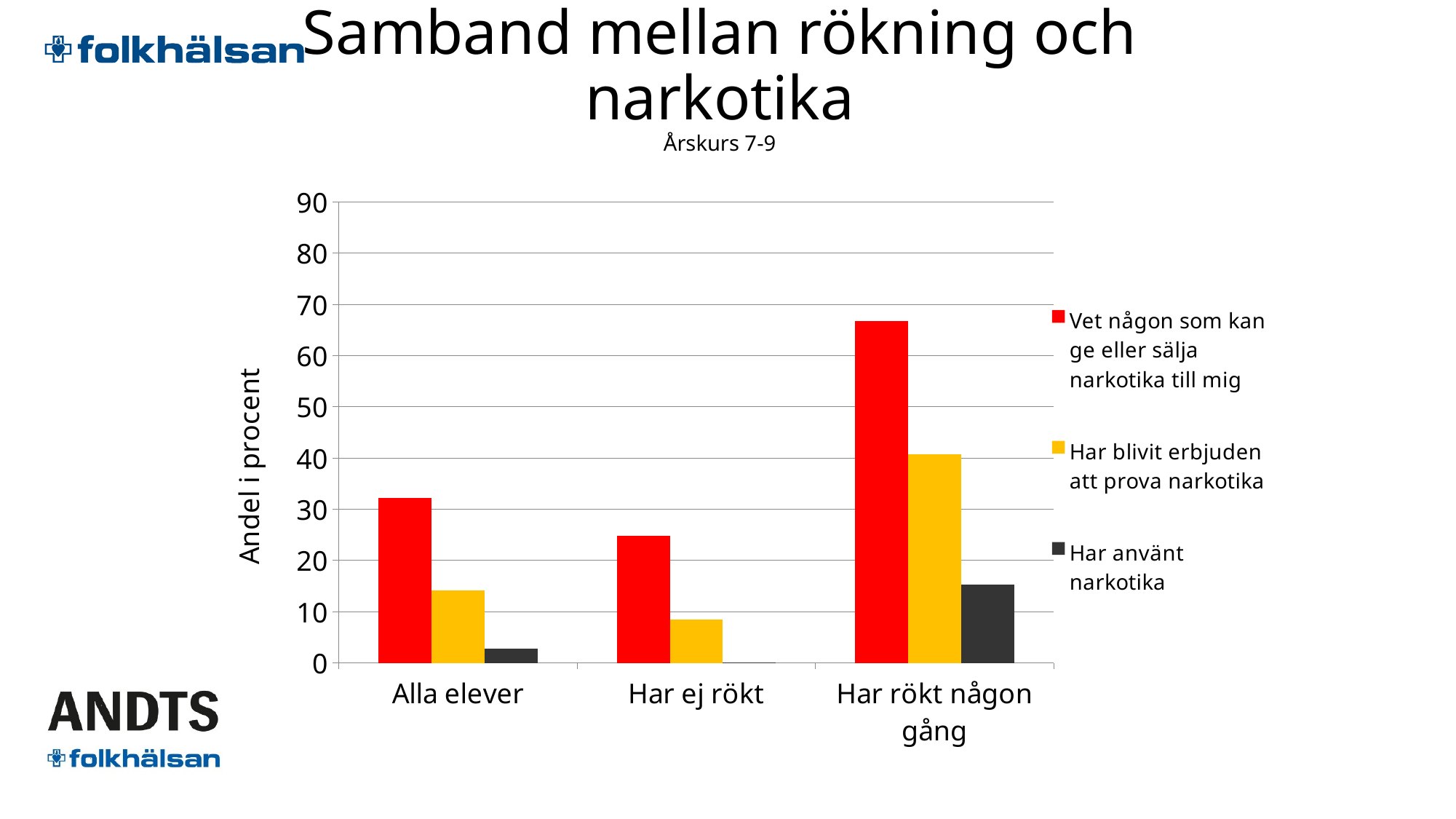
What kind of chart is shown on the slide? bar chart How many series does the legend list? 3 Is the value for 'Har blivit erbjuden att prova narkotika' in 'Alla elever' greater or less than 20? less What is the label on the y axis? Andel i procent Is the value for 'Vet någon som kan ge eller sälja narkotika till mig' in 'Alla elever' greater or less than 40? less Which is larger for 'Vet någon som kan ge eller sälja narkotika till mig': 'Alla elever' or 'Har ej rökt'? Alla elever Which is larger for 'Har blivit erbjuden att prova narkotika': 'Har rökt någon gång' or 'Alla elever'? Har rökt någon gång Which category has the highest value for 'Vet någon som kan ge eller sälja narkotika till mig'? Har rökt någon gång Is the value for 'Vet någon som kan ge eller sälja narkotika till mig' in 'Har rökt någon gång' greater or less than 60? greater Which colour represents 'Har använt narkotika' in the legend? dark grey Which category has the lowest value for 'Har använt narkotika'? Har ej rökt How many categories are shown on the x axis? 3